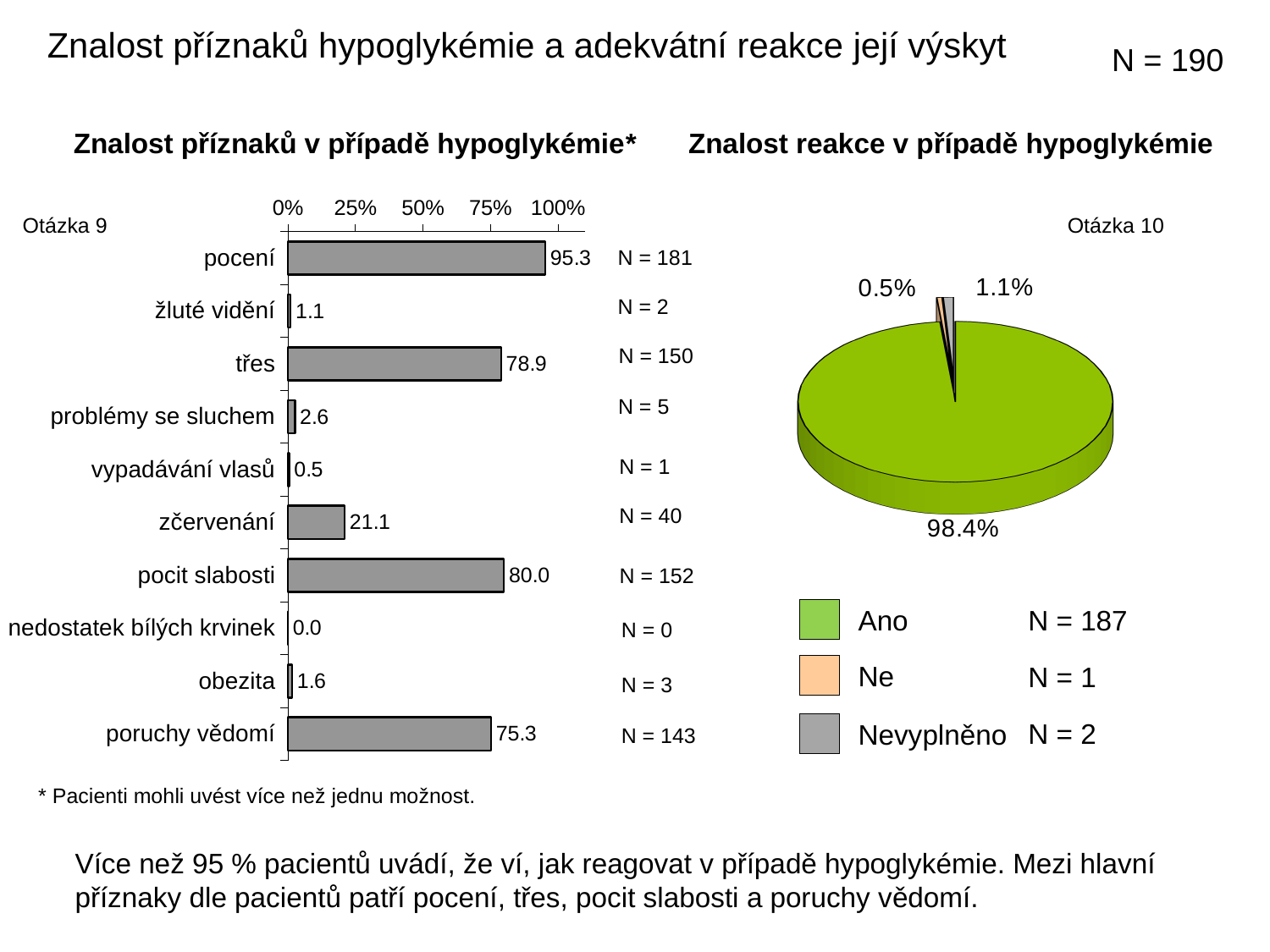
In the bar chart 'Znalost příznaků v případě hypoglykémie*', what is the difference between the values for 'pocit slabosti' and 'zčervenání'? 58.9 How many entries does the legend of the pie chart 'Znalost reakce v případě hypoglykémie' list? 3 In the bar chart 'Znalost příznaků v případě hypoglykémie*', how many categories are shown? 10 In the bar chart 'Znalost příznaků v případě hypoglykémie*', what is the value for 'pocení'? 95.3 In the bar chart 'Znalost příznaků v případě hypoglykémie*', what is the value for 'třes'? 78.9 In the bar chart 'Znalost příznaků v případě hypoglykémie*', which category has the highest value? pocení What kind of chart is 'Znalost příznaků v případě hypoglykémie*'? bar chart In the bar chart 'Znalost příznaků v případě hypoglykémie*', which is larger: the value for 'pocit slabosti' or 'poruchy vědomí'? pocit slabosti In the bar chart 'Znalost příznaků v případě hypoglykémie*', which category has the lowest value? nedostatek bílých krvinek In the pie chart 'Znalost reakce v případě hypoglykémie', what is the N value for 'Nevyplněno'? N = 2 What kind of chart is 'Znalost reakce v případě hypoglykémie'? pie chart In the pie chart 'Znalost reakce v případě hypoglykémie', what share does 'Ano' have? 98.4%